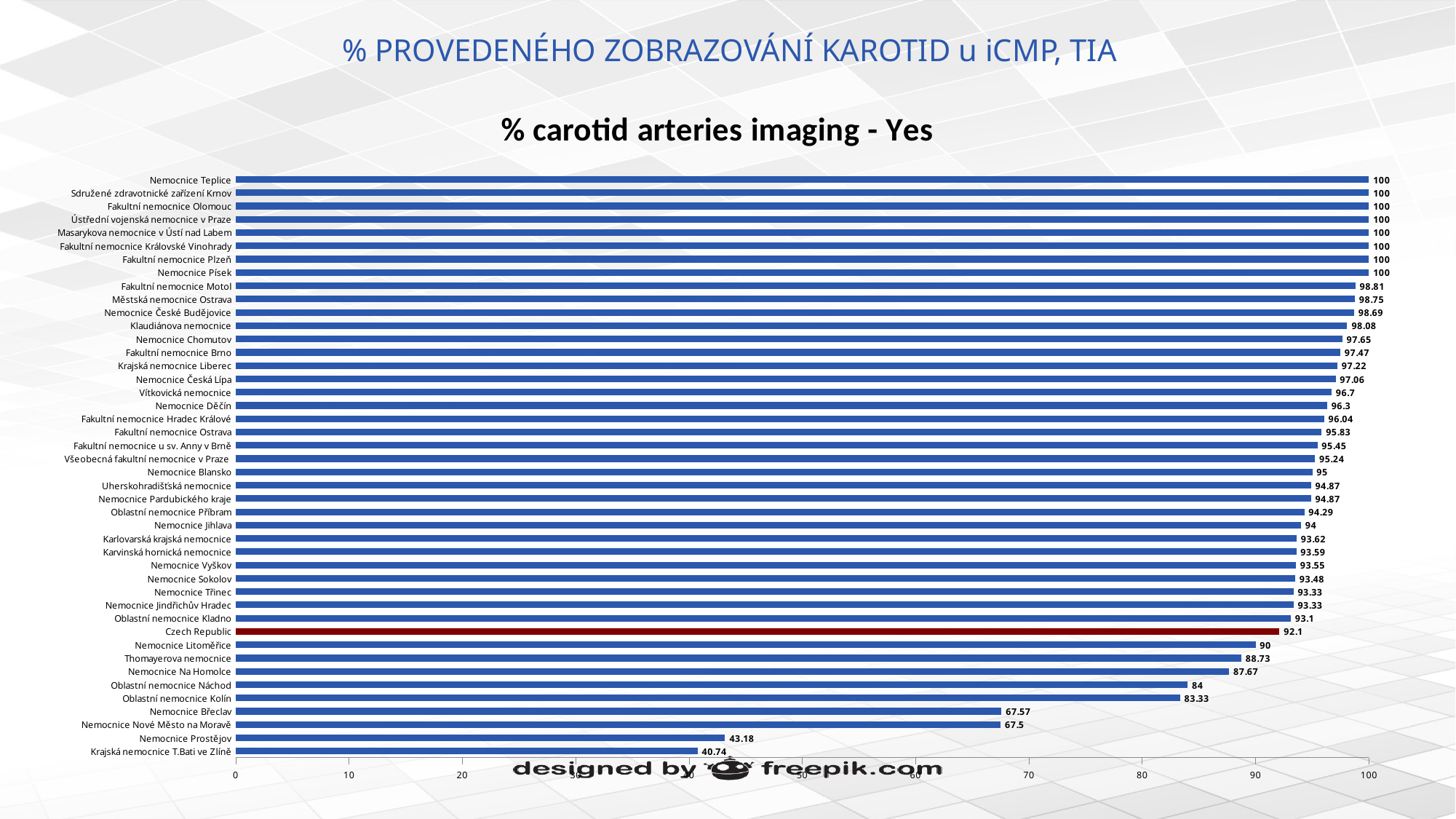
What is the chart title? % carotid arteries imaging - Yes Which is larger, the value for Nemocnice Břeclav or Nemocnice Nové Město na Moravě? Nemocnice Břeclav How many hospitals have a value of 100? 8 What is the value for Czech Republic? 92.1 Which hospital has the lowest value? Krajská nemocnice T.Bati ve Zlíně What is the difference between the values for Nemocnice Litoměřice and Oblastní nemocnice Náchod? 6 What is the value for Fakultní nemocnice Motol? 98.81 What is the value for Nemocnice Prostějov? 43.18 How many categories (bars) are shown in the chart? 44 What kind of chart is shown? bar chart Is the value for Oblastní nemocnice Kolín greater or less than 90? less Which bar is shown in a different colour (dark red) from the others? Czech Republic